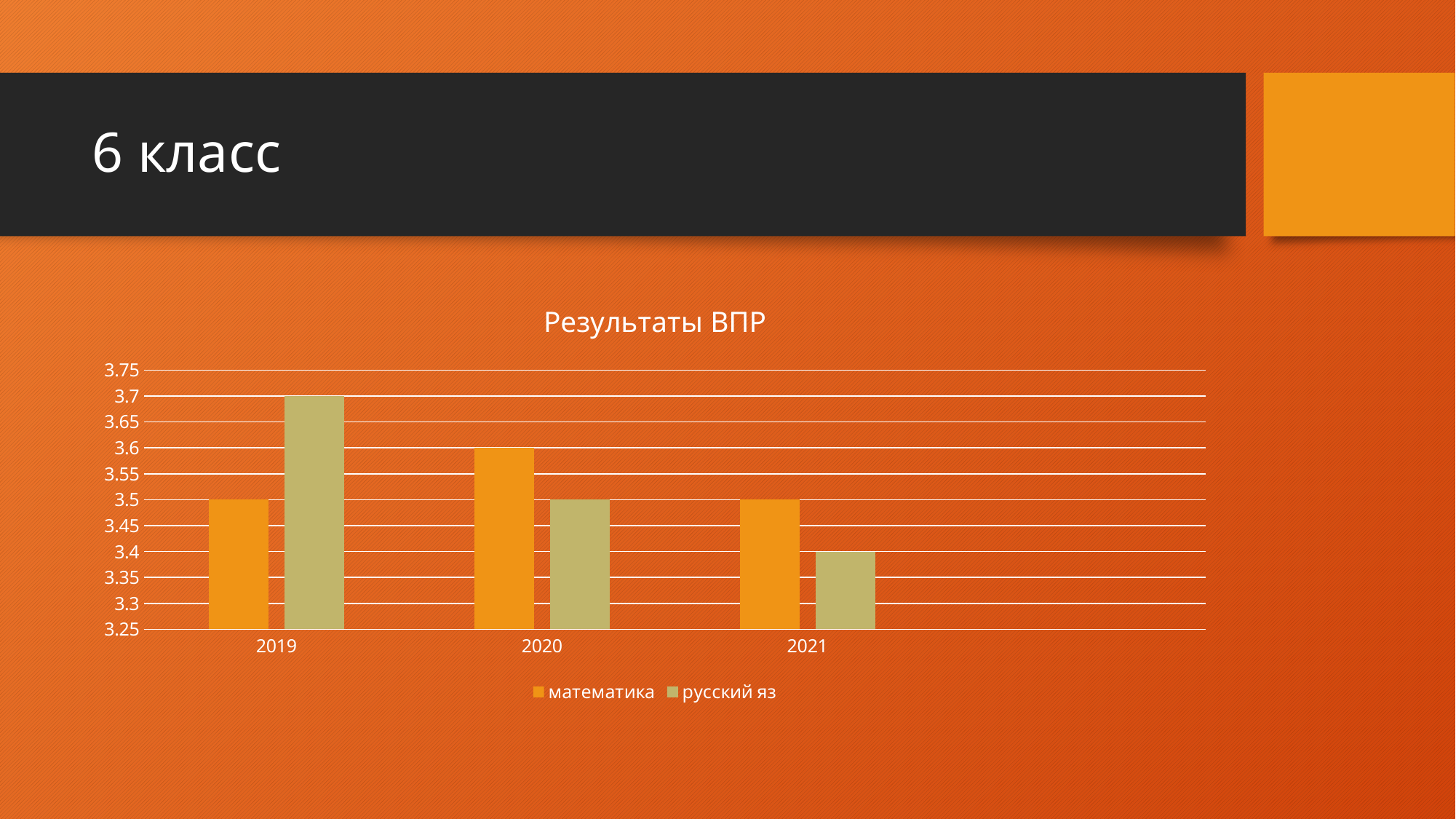
What type of chart is shown on the slide? bar chart How many series does the legend list? 2 What is the value for русский яз in 2021? 3.4 What is the value for математика in 2020? 3.6 What is the difference between русский яз and математика in 2019? 0.2 Does the value for русский яз rise or fall from 2019 to 2021? fall What is the title of the chart? Результаты ВПР What is the value for русский яз in 2019? 3.7 Which is larger in 2020, математика or русский яз? математика In which year is the value for русский яз the lowest? 2021 How many years are shown on the x axis? 3 In which year is the value for русский яз the highest? 2019